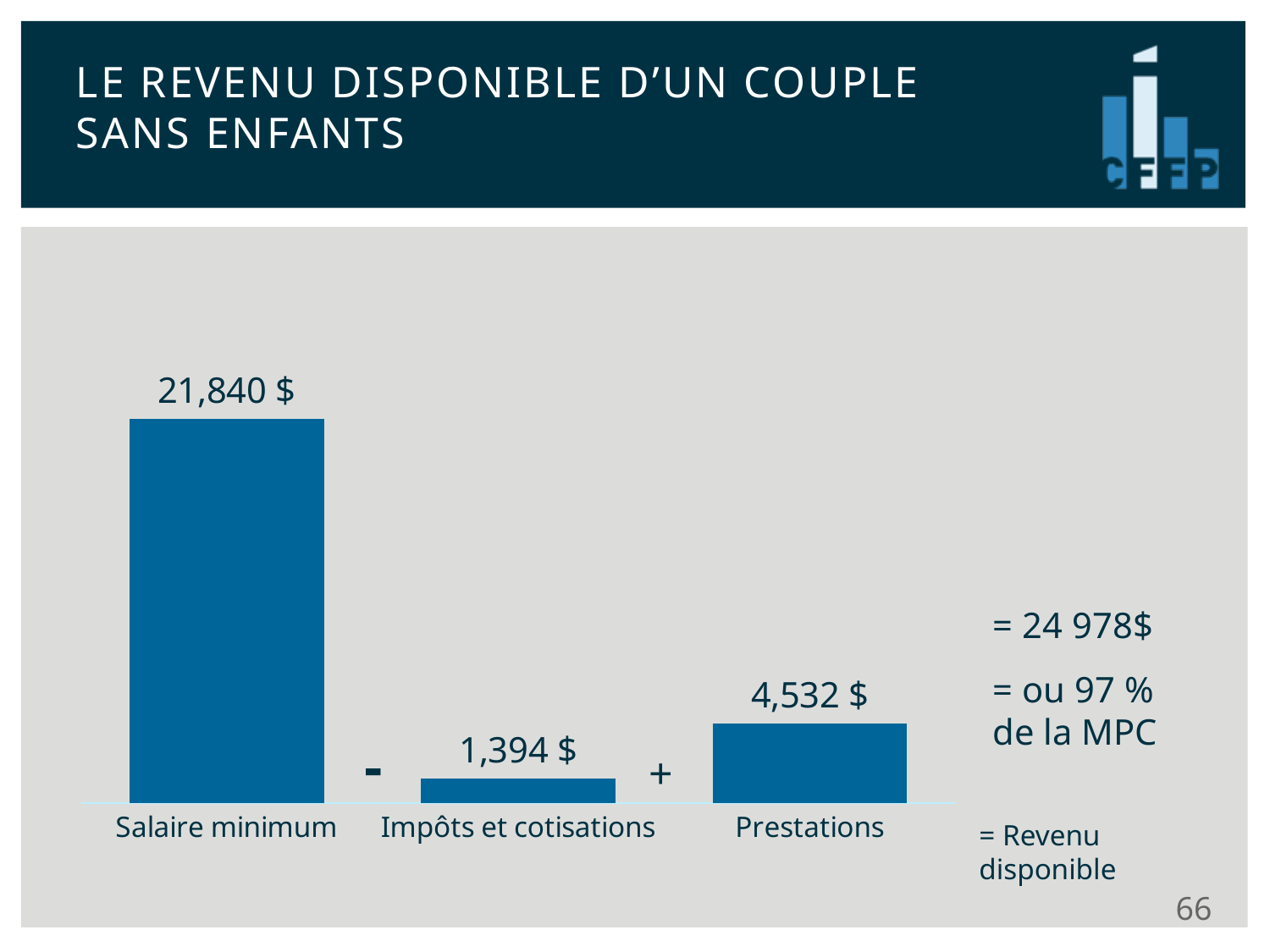
What percentage of the MPC does the Revenu disponible represent, according to the slide? 97 % Which category has the highest value? Salaire minimum How many bars are shown in the chart? 3 What is the value of the Impôts et cotisations bar? 1,394 $ What is the difference between the Salaire minimum and Prestations values? 17,308 $ What is the difference between the Prestations and Impôts et cotisations values? 3,138 $ Which category has the lowest value? Impôts et cotisations What type of chart is shown on the slide? Bar chart What is the value of the Prestations bar? 4,532 $ What is the Revenu disponible amount stated to the right of the chart? 24 978$ What is the value of the Salaire minimum bar? 21,840 $ Which is larger, Prestations or Impôts et cotisations? Prestations